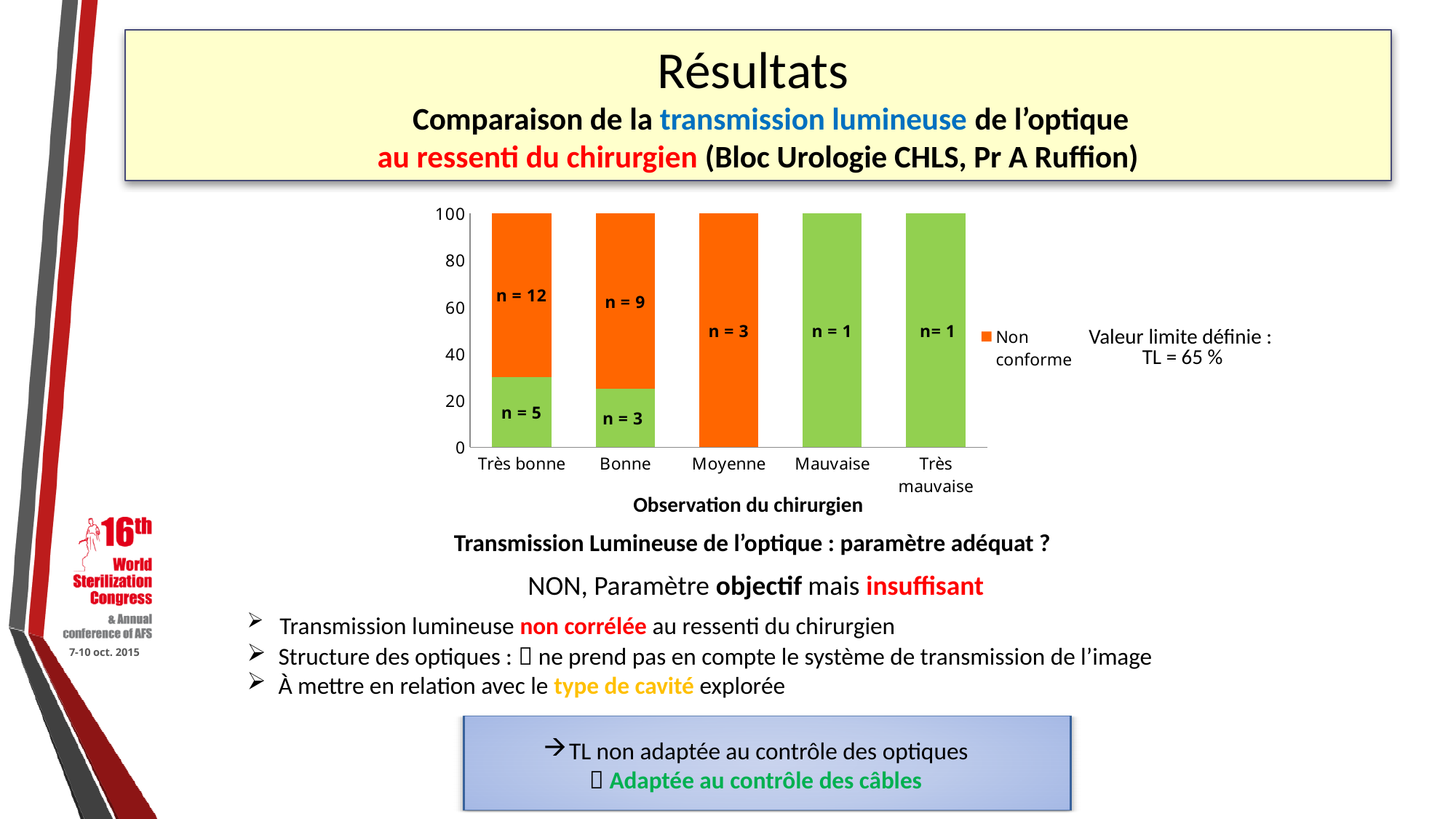
What is the label printed on the green segment of the 'Très bonne' bar? n = 5 What is the label printed on the 'Moyenne' bar? n = 3 Which category has the largest n value printed on its orange segment? Très bonne What is the total n for the 'Très bonne' bar, adding its two printed labels? 17 What is the label printed on the green segment of the 'Bonne' bar? n = 3 How many categories are shown on the x axis of the chart? 5 Is the top of the green segment in the 'Très bonne' bar greater or less than 40 on the y axis? less What is the x-axis title of the chart? Observation du chirurgien What is the label printed on the orange segment of the 'Bonne' bar? n = 9 What type of chart is shown on the slide? stacked bar chart What legend entry is shown next to the chart? Non conforme What is the label printed on the orange segment of the 'Très bonne' bar? n = 12